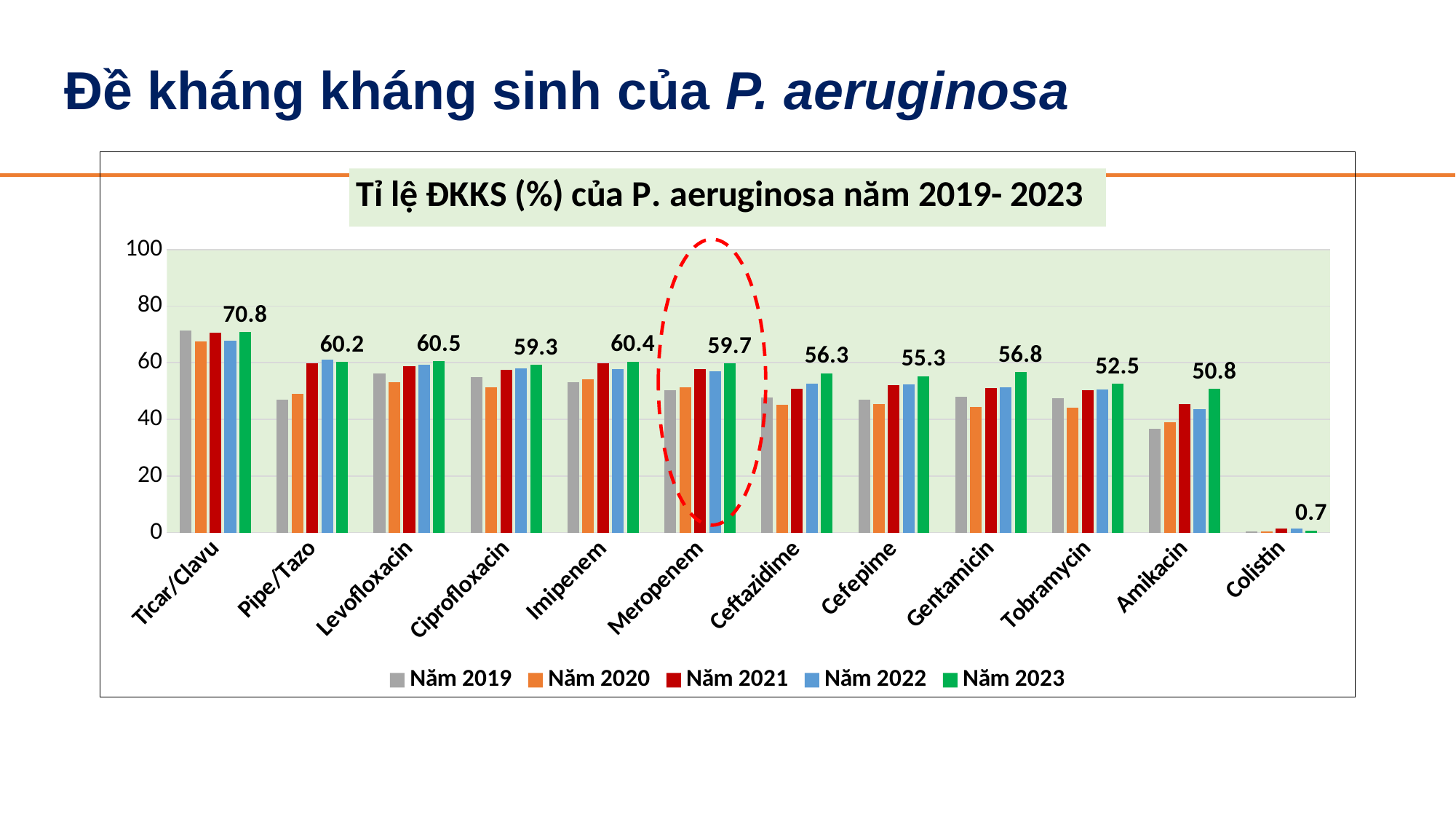
What is the Năm 2023 value for Amikacin? 50.8 What kind of chart is shown on the slide? Bar chart Is the Năm 2019 value for Amikacin greater or less than 40? less How many series does the legend list? 5 What is the difference between the Năm 2023 values for Ticar/Clavu and Tobramycin? 18.3 What is the Năm 2023 value for Colistin? 0.7 What is the Năm 2023 value for Meropenem? 59.7 Which antibiotic has the lowest Năm 2023 value? Colistin How many antibiotics are shown on the x axis? 12 What is the Năm 2023 value for Ticar/Clavu? 70.8 Which is larger for Năm 2023: Gentamicin or Cefepime? Gentamicin Which antibiotic has the highest Năm 2023 value? Ticar/Clavu